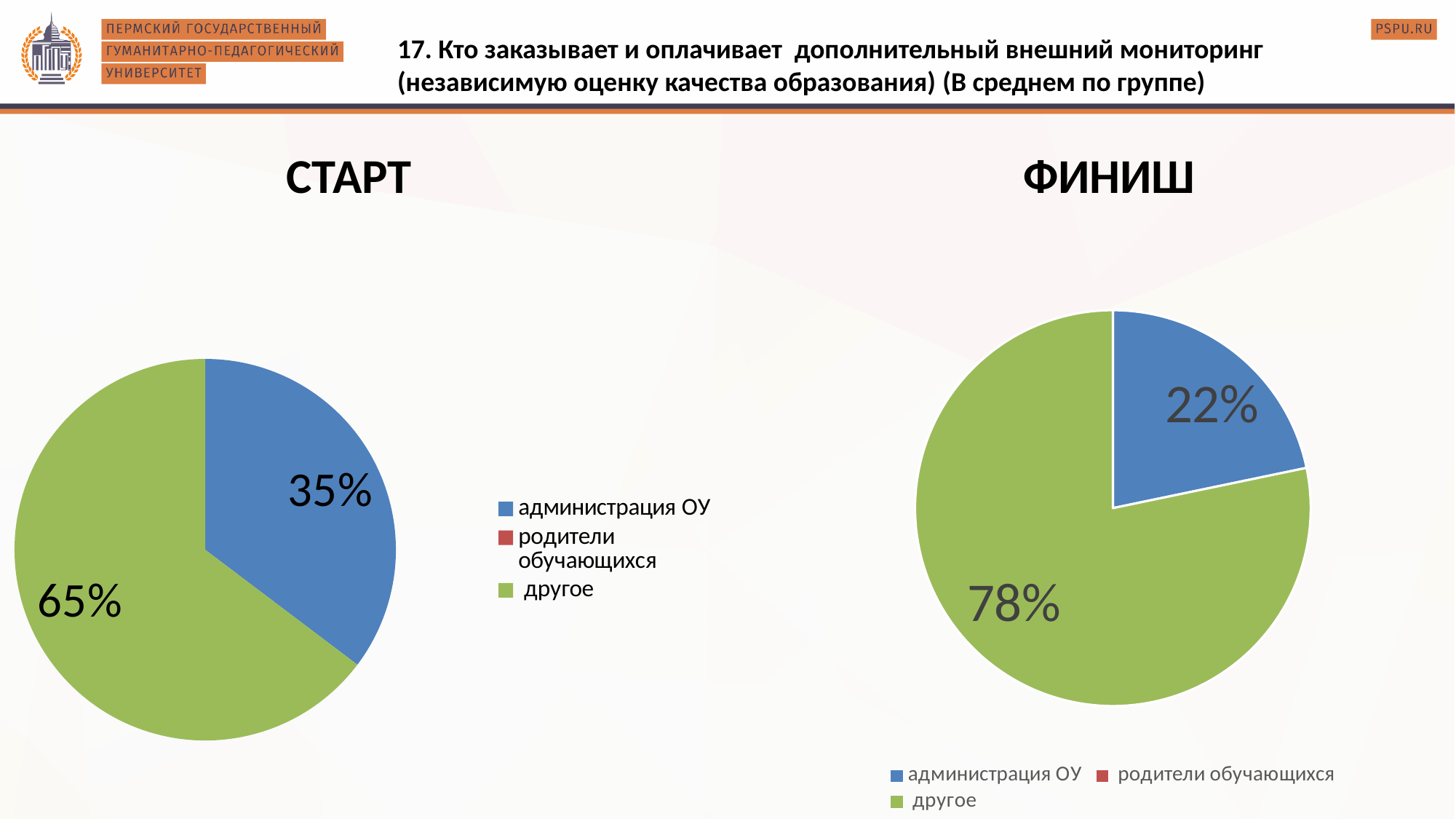
Which chart shows a larger share for администрация ОУ, СТАРТ or ФИНИШ? СТАРТ In the СТАРТ chart, which category has the smallest visible slice? администрация ОУ What type of chart is the СТАРТ chart? pie chart In the ФИНИШ chart, what share is labelled for администрация ОУ? 22% In the ФИНИШ chart, which category has the largest slice? другое How many entries does the legend of the ФИНИШ chart list? 3 In the ФИНИШ chart, what share is labelled for другое? 78% In the СТАРТ chart, what share is labelled for другое? 65% In the СТАРТ chart, what share is labelled for администрация ОУ? 35% In the ФИНИШ chart, what colour is the slice for другое? green In the СТАРТ chart, what is the difference between the другое share and the администрация ОУ share? 30% How many pie charts are shown on the slide? 2